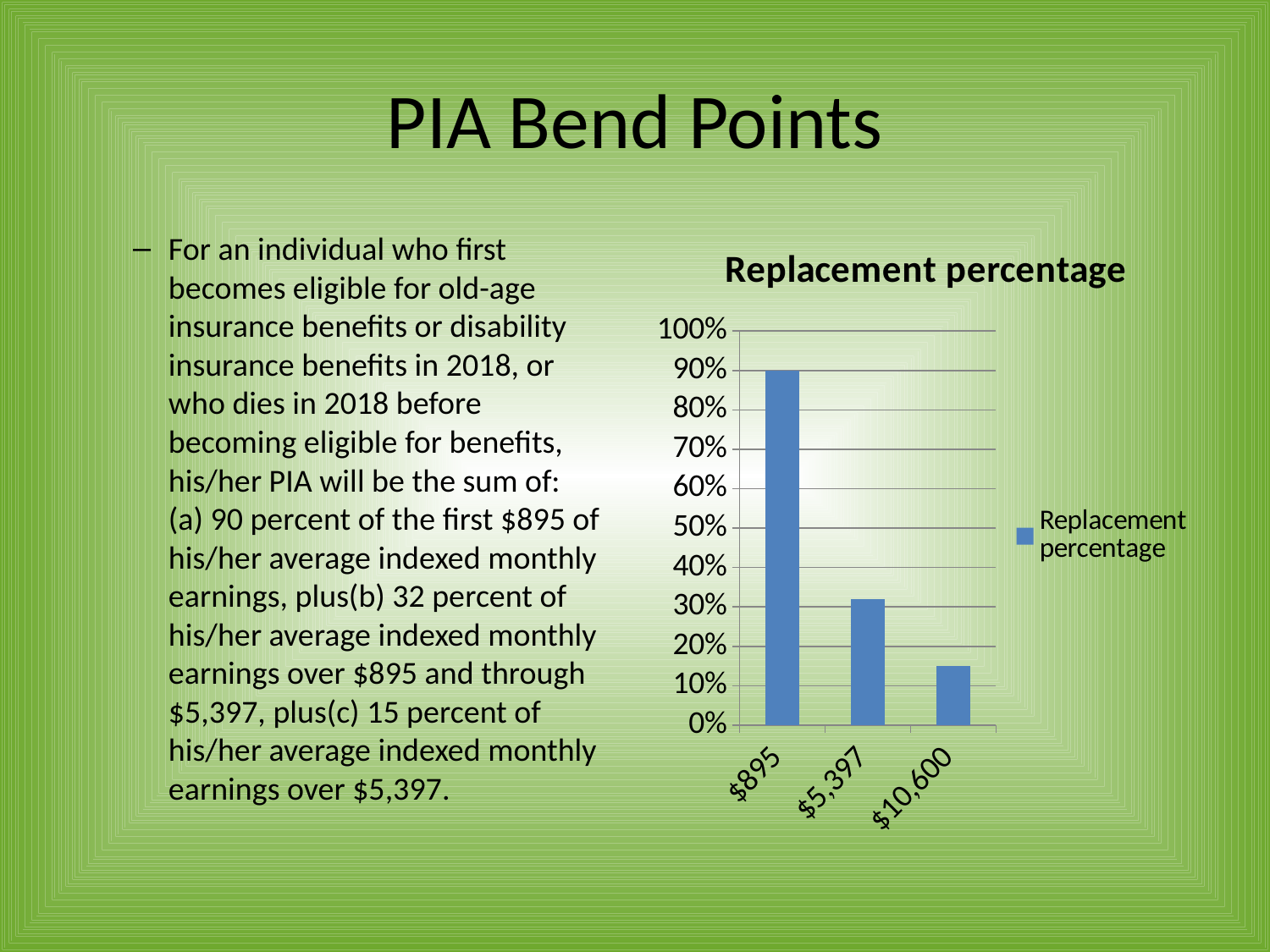
Is the replacement percentage for $5,397 greater or less than 40%? less Which category has the lowest replacement percentage? $10,600 Is the replacement percentage for $5,397 greater or less than 20%? greater How many series does the chart legend list? 1 Which category has the highest replacement percentage? $895 Which is larger, the replacement percentage for $5,397 or for $10,600? $5,397 Do the values rise or fall moving left to right along the x axis? fall Is the replacement percentage for $10,600 greater or less than 10%? greater What is the title of the chart? Replacement percentage How many categories are shown on the x axis of the chart? 3 What is the replacement percentage for the $895 category? 90% What kind of chart is shown on the slide? bar chart